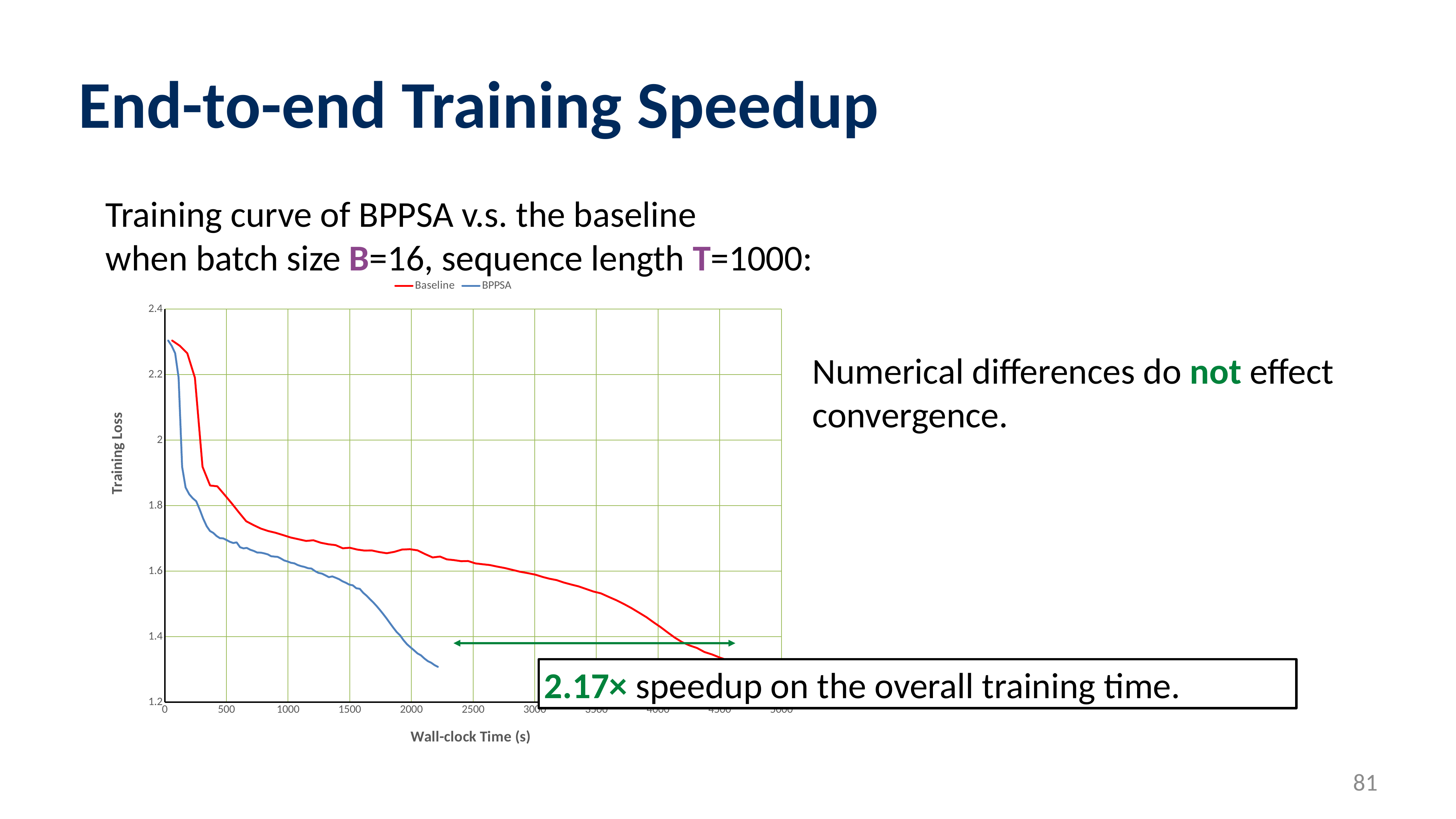
What is the title of the chart's x axis? Wall-clock Time (s) Is the Baseline training loss at 4000 s greater or less than 1.6? less Is the BPPSA training loss at 500 s greater or less than 1.6? greater Which series reaches the end of training in less wall-clock time, Baseline or BPPSA? BPPSA Is the wall-clock time at which the Baseline curve ends greater or less than 4000? greater Which series are listed in the chart's legend? Baseline and BPPSA What kind of chart is shown on the slide? line chart How many series does the chart's legend list? 2 At 2000 s of wall-clock time, which series has the lower training loss, Baseline or BPPSA? BPPSA Does the training loss rise or fall as wall-clock time increases? fall